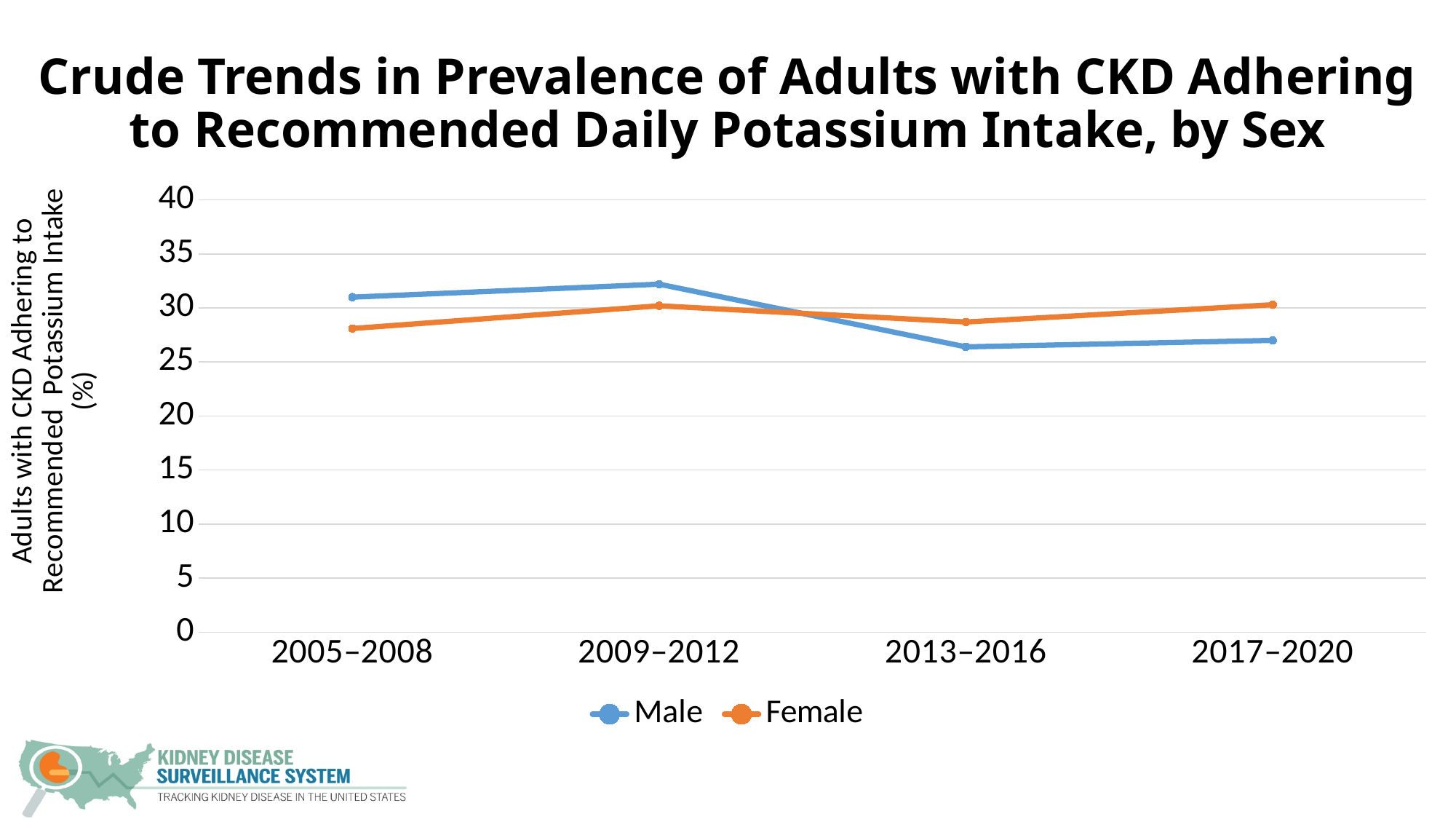
Is the value for Male in 2009–2012 greater or less than 30? greater Is the value for Male in 2013–2016 greater or less than 30? less How many time periods are shown on the x axis? 4 Is the value for Male in 2017–2020 greater or less than 30? less Does the Male series rise or fall from 2009–2012 to 2013–2016? fall What kind of chart is shown on the slide? line chart In 2017–2020, which is larger, the value for Male or for Female? Female In 2005–2008, which is larger, the value for Male or for Female? Male In which period is the Male series at its highest? 2009–2012 Which series is plotted in orange? Female How many series does the legend list? 2